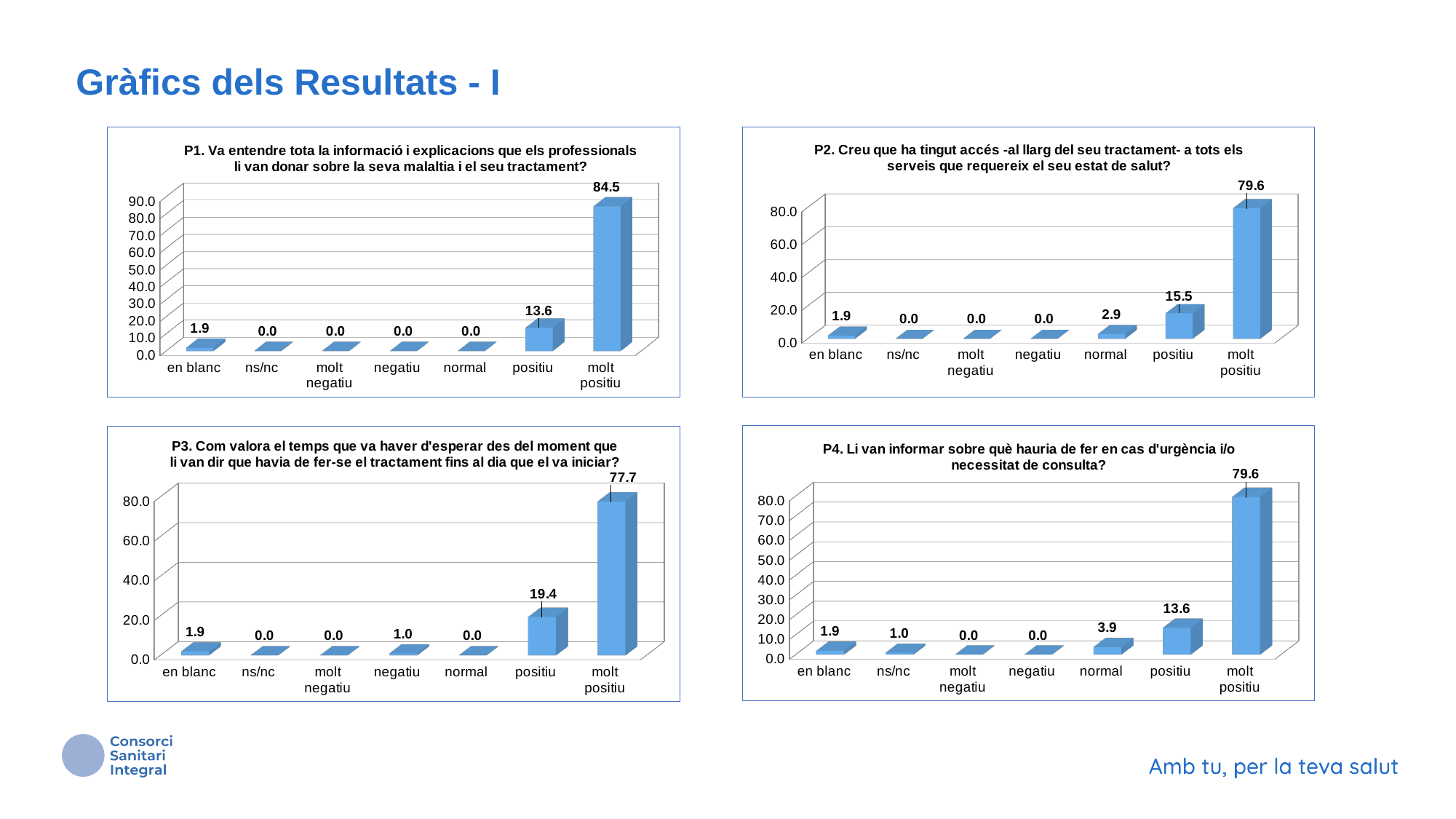
In the P1 chart (top left), what is the value for 'molt positiu'? 84.5 How many categories are shown on the x axis of the P1 chart (top left)? 7 In the P4 chart (bottom right), what is the difference between 'positiu' and 'normal'? 9.7 In the P1 chart (top left), what is the difference between 'molt positiu' and 'positiu'? 70.9 In the P2 chart (top right), which is larger, the value for 'positiu' or the value for 'normal'? positiu How many charts are shown on the slide? 4 In the P3 chart (bottom left), what is the value for 'positiu'? 19.4 In the P4 chart (bottom right), what is the value for 'ns/nc'? 1.0 What kind of chart is the P2 chart (top right)? bar chart In the P2 chart (top right), what is the value for 'normal'? 2.9 In the P3 chart (bottom left), which category has the highest value? molt positiu In the P3 chart (bottom left), is the value for 'molt positiu' greater or less than 60.0? greater